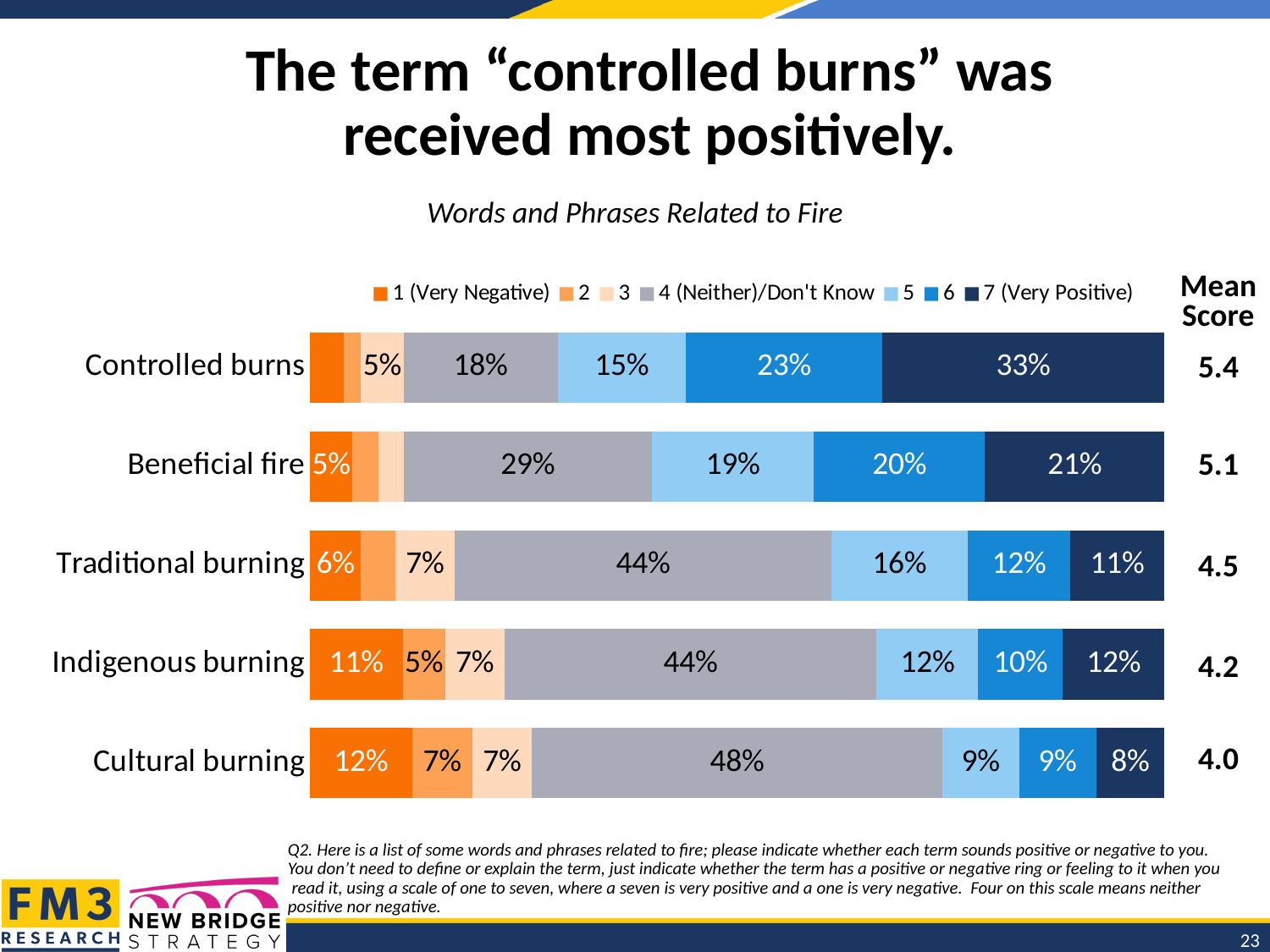
Which term has the largest share of 7 (Very Positive) ratings? Controlled burns How many series does the legend list? 7 Which term has the highest Mean Score? Controlled burns Which has a larger 4 (Neither)/Don't Know share: "Traditional burning" or "Cultural burning"? Cultural burning What kind of chart is shown on the slide? Stacked bar chart How many terms are shown in the chart? 5 What percentage of respondents rated "Indigenous burning" as 1 (Very Negative)? 11% What percentage of respondents rated "Controlled burns" as 7 (Very Positive)? 33% What percentage of respondents rated "Cultural burning" as 4 (Neither)/Don't Know? 48% What is the Mean Score for "Beneficial fire"? 5.1 What is the difference between the 7 (Very Positive) share for "Controlled burns" and for "Beneficial fire"? 12% Which term has the lowest Mean Score? Cultural burning